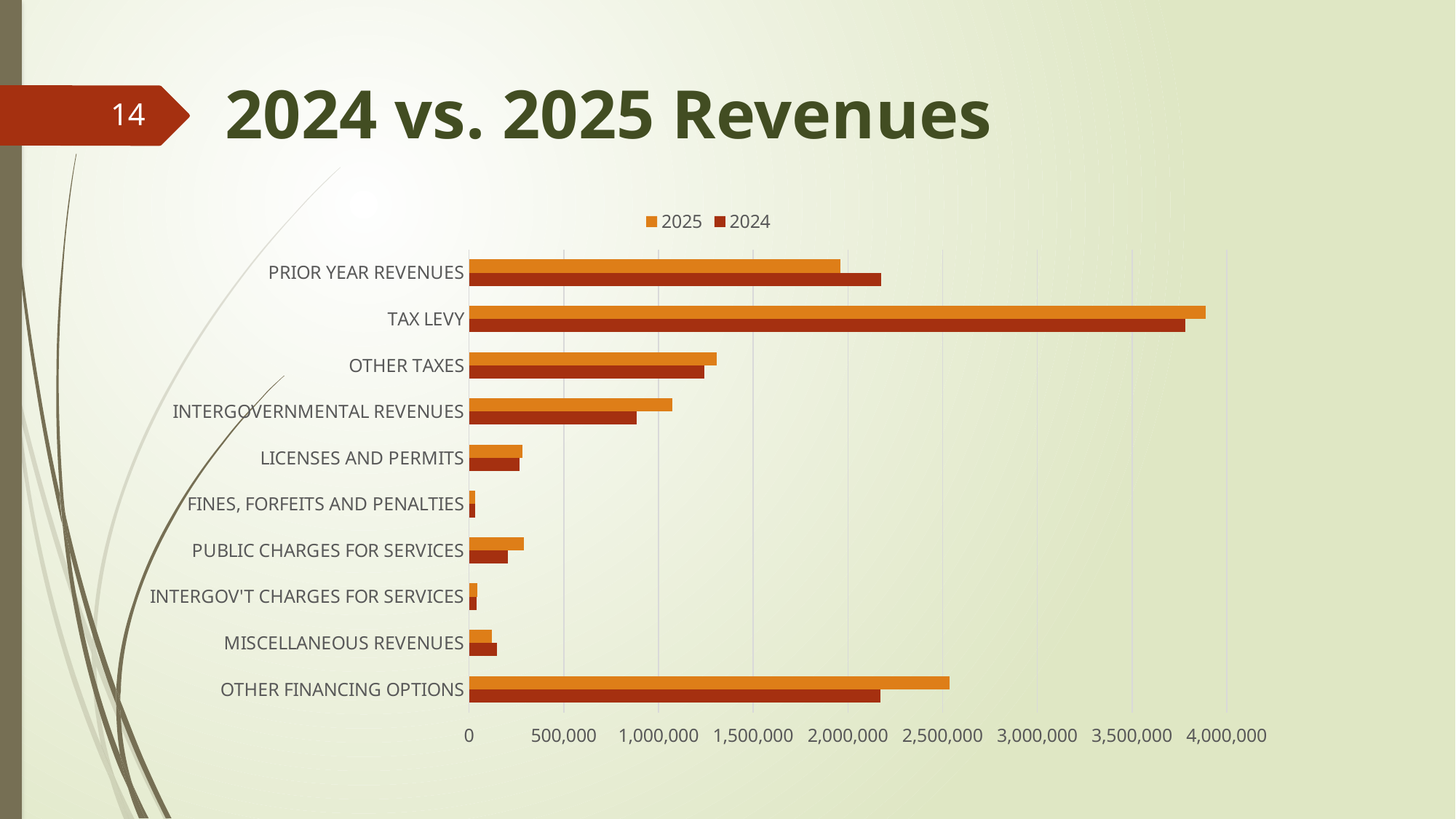
For OTHER FINANCING OPTIONS, which year has the larger value, 2024 or 2025? 2025 Is the 2025 value for OTHER FINANCING OPTIONS greater or less than 2,000,000? greater Which category has the highest 2025 revenue? TAX LEVY Is the 2025 value for MISCELLANEOUS REVENUES greater or less than 500,000? less Is the 2025 value for TAX LEVY greater or less than 3,500,000? greater What kind of chart is shown on the slide? bar chart For PRIOR YEAR REVENUES, which year has the larger value, 2024 or 2025? 2024 Which series is shown in the darker red colour in the legend? 2024 How many revenue categories are plotted on the chart? 10 Which category has the highest 2024 revenue? TAX LEVY How many series does the legend list? 2